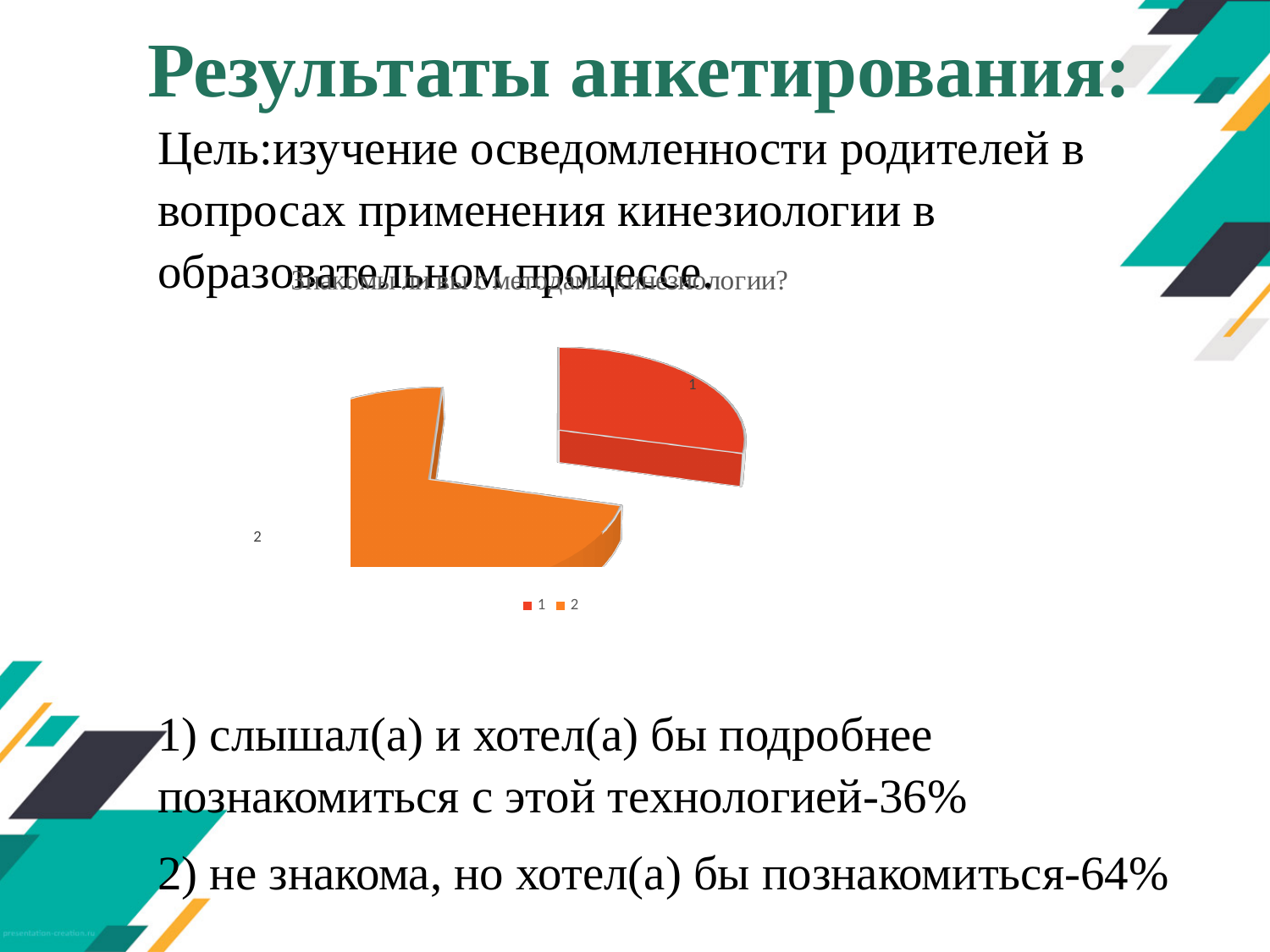
Which slice of the pie chart is the smallest? 1 Which slice of the pie chart is the largest? 2 What colour is slice 2 in the pie chart? orange What kind of chart is shown on the slide? pie chart Which slice of the pie chart is larger, 1 or 2? 2 According to the slide, what share of respondents does slice 2 (не знакома, но хотел(а) бы познакомиться) represent? 64% What colour is slice 1 in the pie chart? red How many slices does the pie chart have? 2 How many entries does the legend of the pie chart list? 2 According to the slide, what share of respondents does slice 1 (слышал(а) и хотел(а) бы подробнее познакомиться с этой технологией) represent? 36%